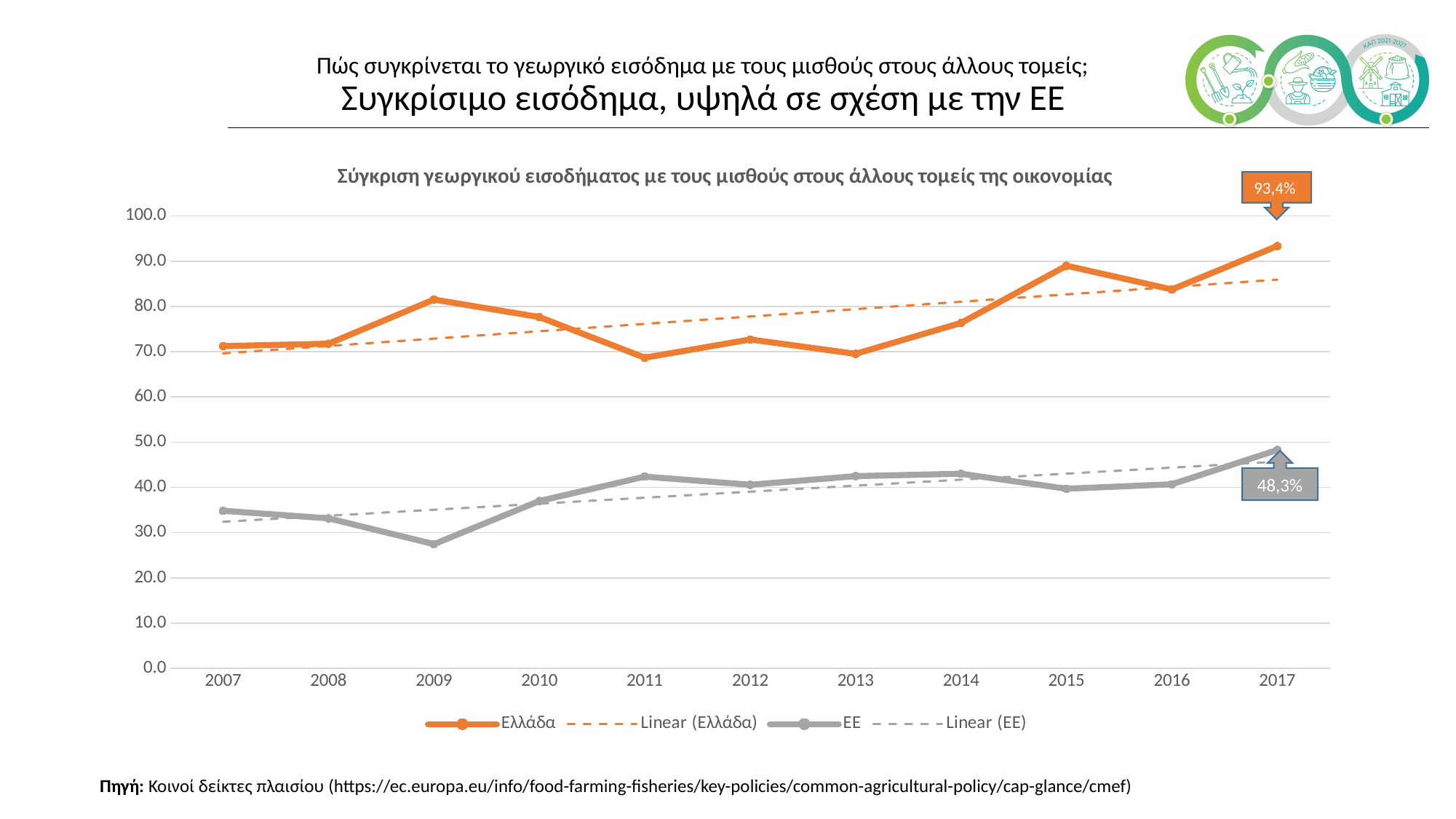
How many years are shown on the x axis? 11 What kind of chart is shown on the slide? Line chart What is the difference between the Ελλάδα and ΕΕ values in 2017? 45,1 Does the ΕΕ series overall rise or fall from 2007 to 2017? Rise Is the value for Ελλάδα in 2015 greater or less than 80.0? greater In 2017, which series has the larger value, Ελλάδα or ΕΕ? Ελλάδα How many entries does the legend list? 4 What is the value for Ελλάδα in 2017? 93,4% In which year does the ΕΕ series reach its lowest value? 2009 Is the value for ΕΕ in 2009 greater or less than 30.0? less What is the value for ΕΕ in 2017? 48,3% In which year does the Ελλάδα series reach its highest value? 2017